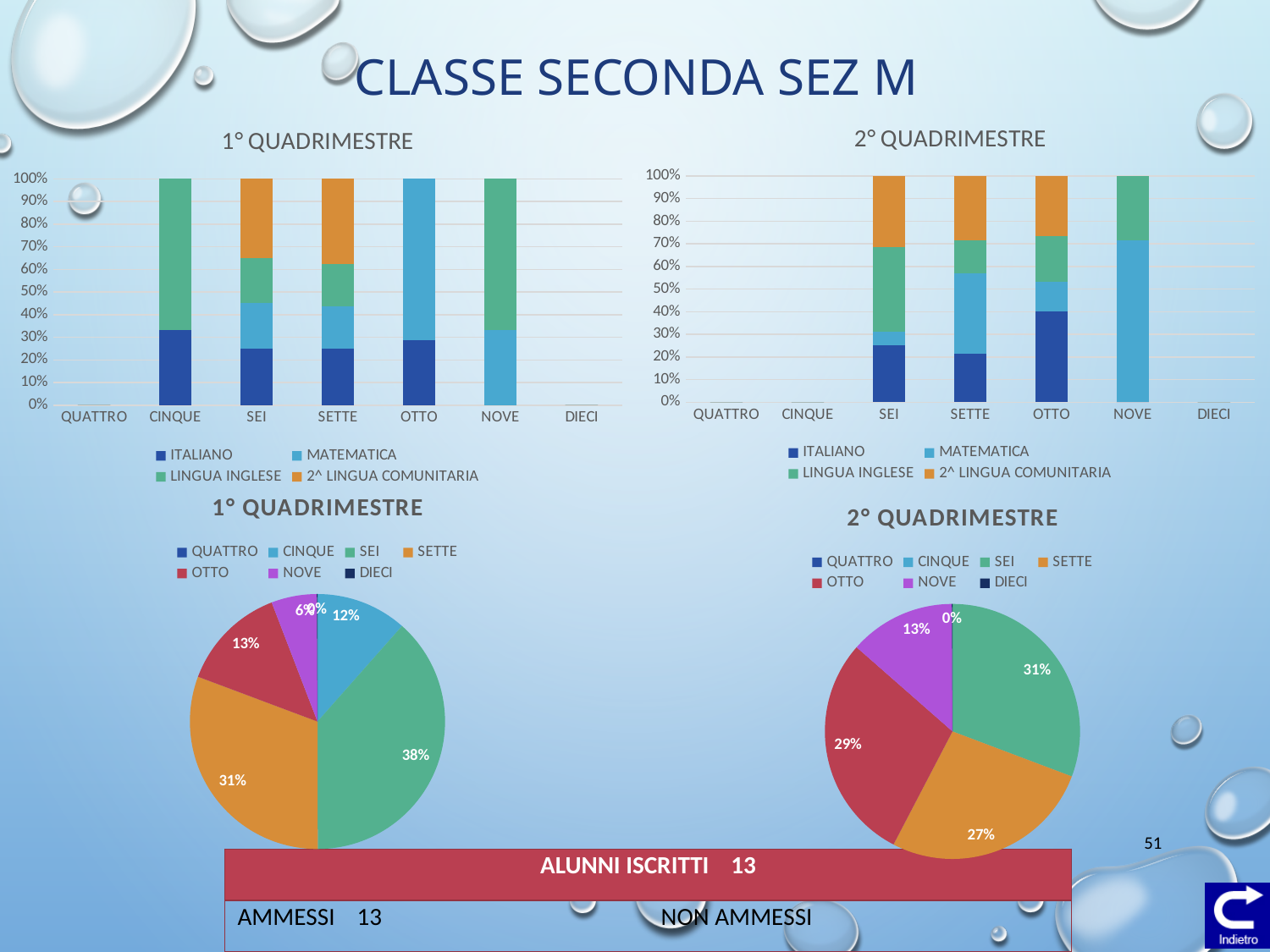
In the 2° Quadrimestre pie chart, which category has the largest slice? SEI In the 1° Quadrimestre pie chart, what is the difference between the SEI slice and the SETTE slice? 7% In the 2° Quadrimestre bar chart, does the ITALIANO segment for OTTO reach greater or less than 30%? greater How many categories are shown on the x axis of the 2° Quadrimestre bar chart? 7 How many series does the legend of the 1° Quadrimestre bar chart list? 4 What kind of chart is the 2° Quadrimestre chart at the top right of the slide? Stacked bar chart In the 1° Quadrimestre bar chart, which series is shown in orange according to the legend? 2^ LINGUA COMUNITARIA In the 1° Quadrimestre pie chart, what share does the SEI slice have? 38% In the 2° Quadrimestre pie chart, what share does the OTTO slice have? 29% In the 1° Quadrimestre pie chart, which category has the largest slice? SEI In the 2° Quadrimestre pie chart, which slice is larger, OTTO or SETTE? OTTO In the 2° Quadrimestre pie chart, what share does the NOVE slice have? 13%